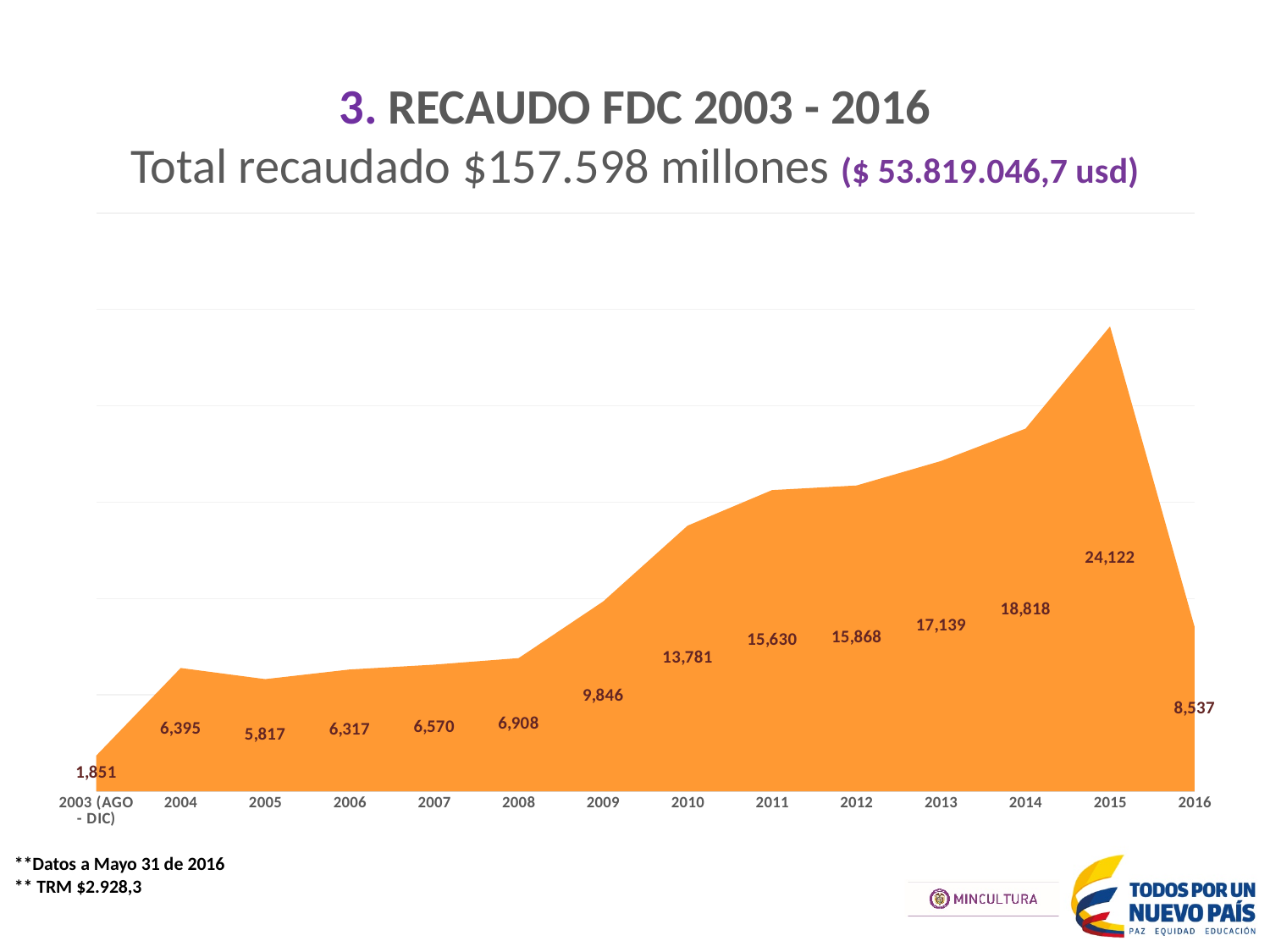
How many years are plotted on the chart? 14 Which year has the highest value? 2015 Which year has the lowest value? 2003 (AGO - DIC) What is the value for 2016? 8,537 Which is larger, the value for 2004 or the value for 2005? 2004 Do the values rise or fall from 2005 to 2015? Rise What is the value for 2009? 9,846 What is the value for 2015? 24,122 What is the difference between the values for 2010 and 2009? 3,935 What kind of chart is shown on the slide? Area chart What is the value for 2003 (AGO - DIC)? 1,851 What is the difference between the values for 2015 and 2014? 5,304